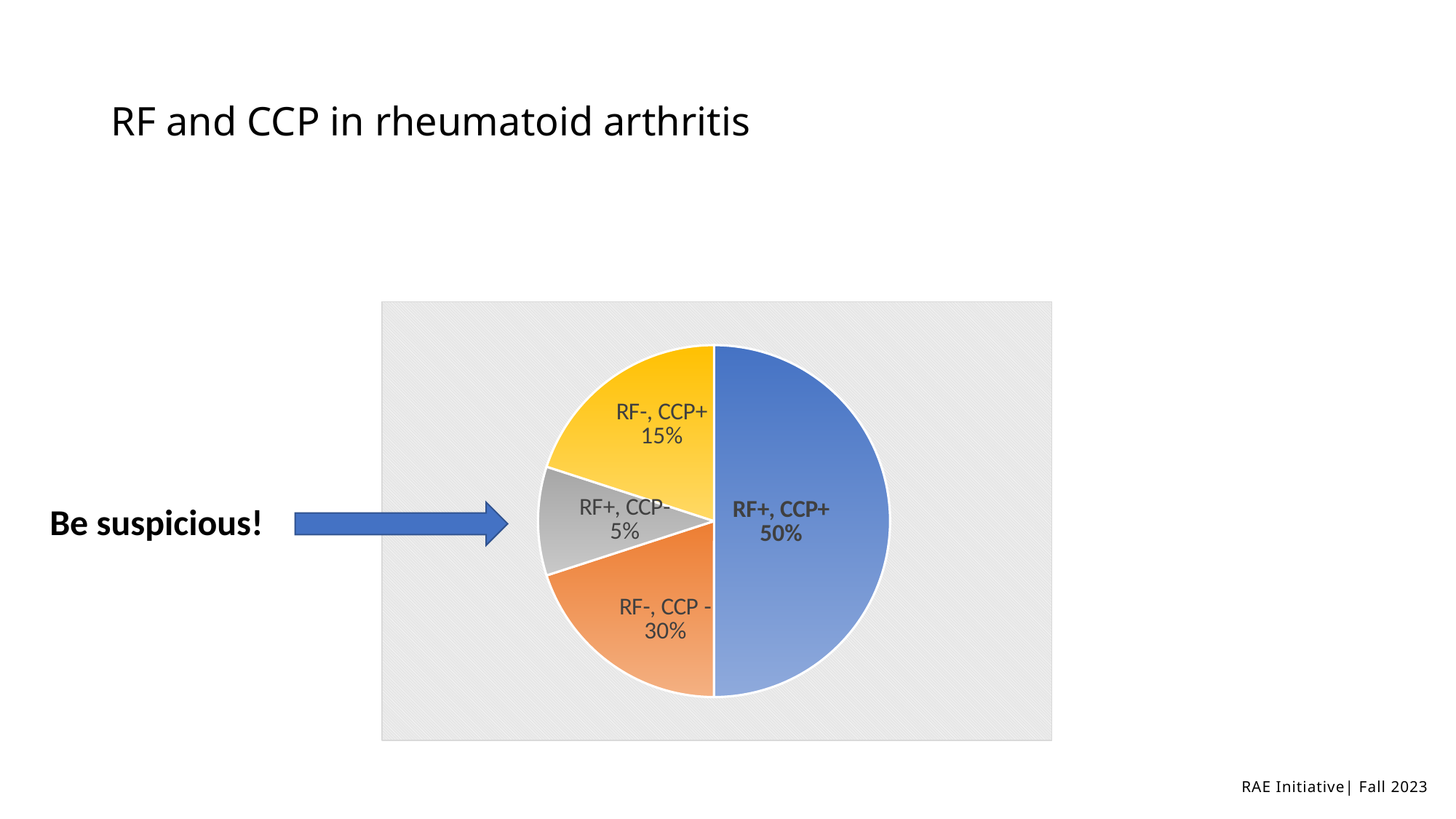
What is the difference between the RF+, CCP+ share and the RF-, CCP- share? 20% What kind of chart is shown on the slide? pie chart What share of the pie is RF+, CCP-? 5% Which slice of the pie is the largest? RF+, CCP+ Which slice of the pie is the smallest? RF+, CCP- What is the combined share of the RF-, CCP+ and RF+, CCP- slices? 20% What share of the pie is RF-, CCP+? 15% What share of the pie is RF+, CCP+? 50% What colour is the RF+, CCP+ slice? blue Which is larger, the RF-, CCP+ slice or the RF+, CCP- slice? RF-, CCP+ How many slices does the pie chart have? 4